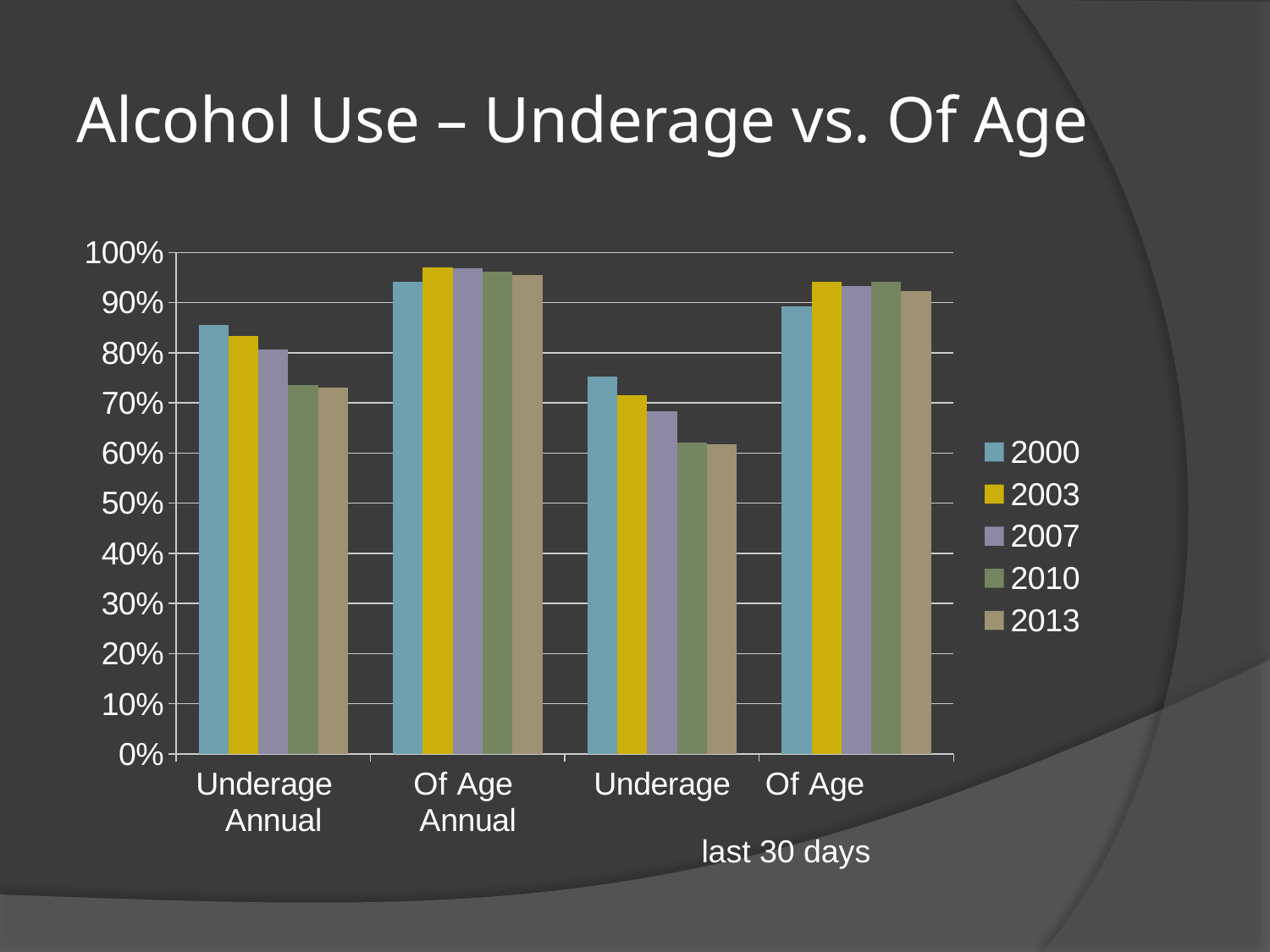
Which year has the highest value for Underage Annual? 2000 What is the title of the slide? Alcohol Use – Underage vs. Of Age Is the value for Underage (last 30 days) in 2000 greater or less than 70%? greater What kind of chart is shown on the slide? bar chart How many series does the legend list? 5 Is the value for Of Age Annual in 2003 greater or less than 90%? greater Is the value for Underage Annual in 2000 greater or less than 80%? greater Do the Underage Annual values rise or fall from 2000 to 2013? fall Which is larger in 2000: Underage Annual or Underage (last 30 days)? Underage Annual How many categories are shown along the x axis? 4 Which year has the highest value for Underage (last 30 days)? 2000